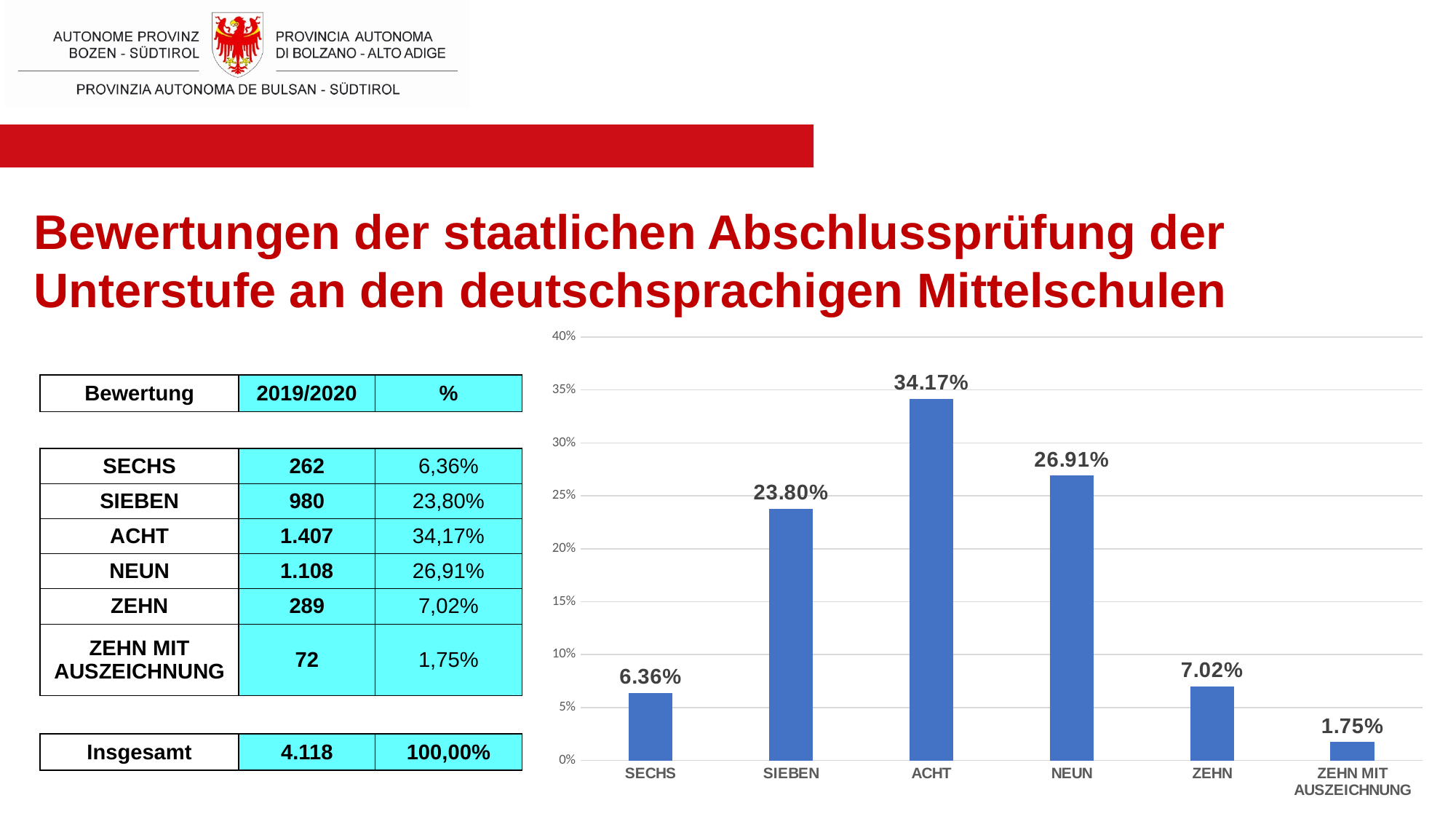
Which category has the highest value in the bar chart? ACHT What is the value shown for SECHS in the bar chart? 6.36% Is the value for ZEHN in the bar chart greater or less than 10%? less What is the difference between the values for ZEHN and SECHS in the bar chart? 0.66% What is the difference between the values for ACHT and NEUN in the bar chart? 7.26% Which is larger in the bar chart, the value for SIEBEN or the value for NEUN? NEUN What is the highest value labelled on the y axis of the bar chart? 40% What is the value shown for ACHT in the bar chart? 34.17% What kind of chart is shown on the slide? bar chart What is the value shown for ZEHN MIT AUSZEICHNUNG in the bar chart? 1.75% How many categories are shown on the x axis of the bar chart? 6 Which category has the lowest value in the bar chart? ZEHN MIT AUSZEICHNUNG